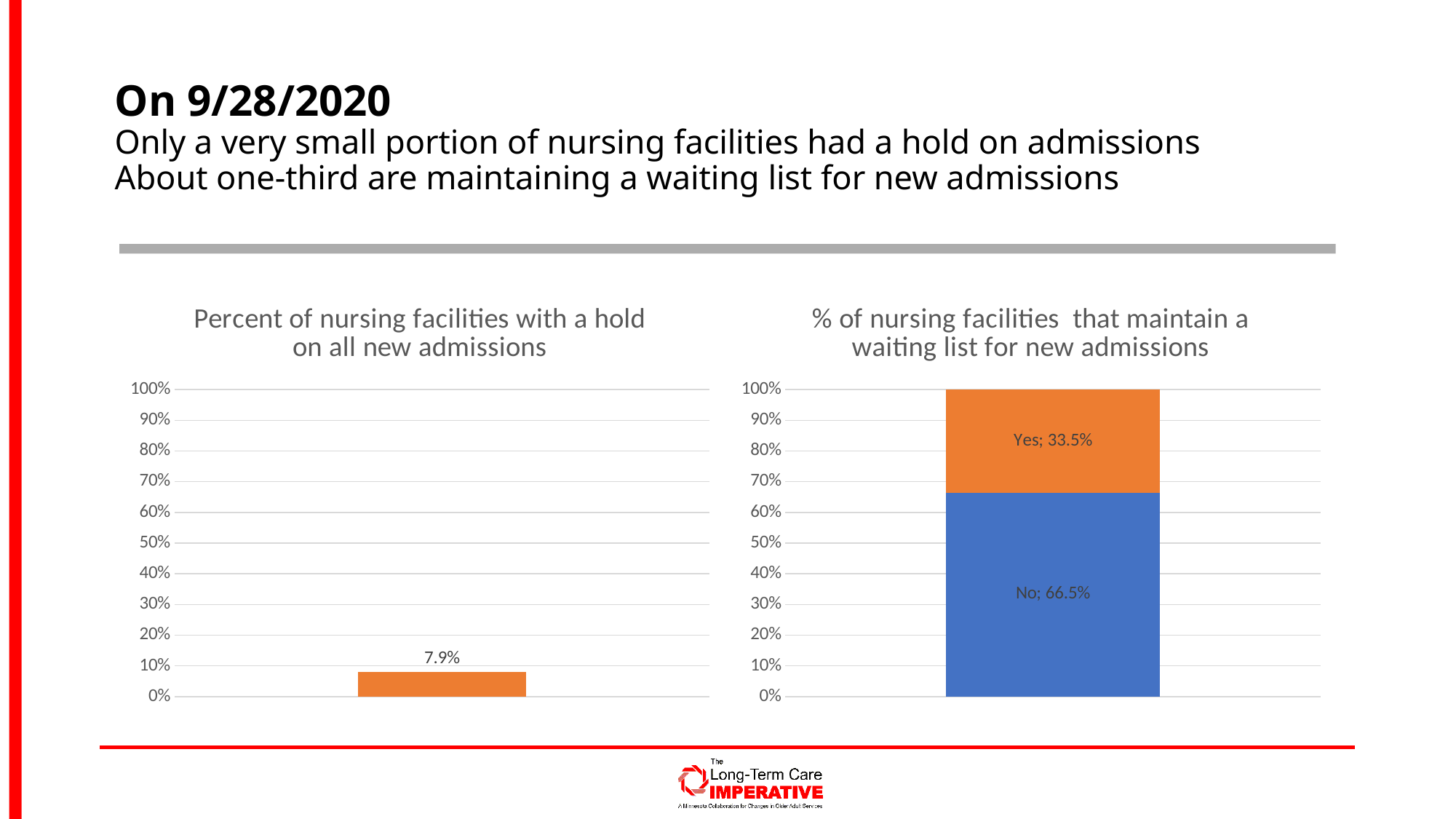
In the chart '% of nursing facilities that maintain a waiting list for new admissions', what is the total of the stacked bar? 100% In the chart '% of nursing facilities that maintain a waiting list for new admissions', what is the value for 'Yes'? 33.5% What kind of chart is 'Percent of nursing facilities with a hold on all new admissions'? bar chart In the chart 'Percent of nursing facilities with a hold on all new admissions', what value is shown for the bar? 7.9% In the chart '% of nursing facilities that maintain a waiting list for new admissions', what is the value for 'No'? 66.5% In the chart '% of nursing facilities that maintain a waiting list for new admissions', how many segments make up the stacked bar? 2 In the chart '% of nursing facilities that maintain a waiting list for new admissions', is the value for 'Yes' greater or less than 30%? greater What is the highest value shown on the y axis of the chart on the left? 100% In the chart '% of nursing facilities that maintain a waiting list for new admissions', which segment is larger, 'Yes' or 'No'? No In the chart '% of nursing facilities that maintain a waiting list for new admissions', what is the difference between the 'No' and 'Yes' values? 33.0% In the chart 'Percent of nursing facilities with a hold on all new admissions', is the bar's value greater or less than 10%? less In the chart '% of nursing facilities that maintain a waiting list for new admissions', what colour is the 'No' segment? blue